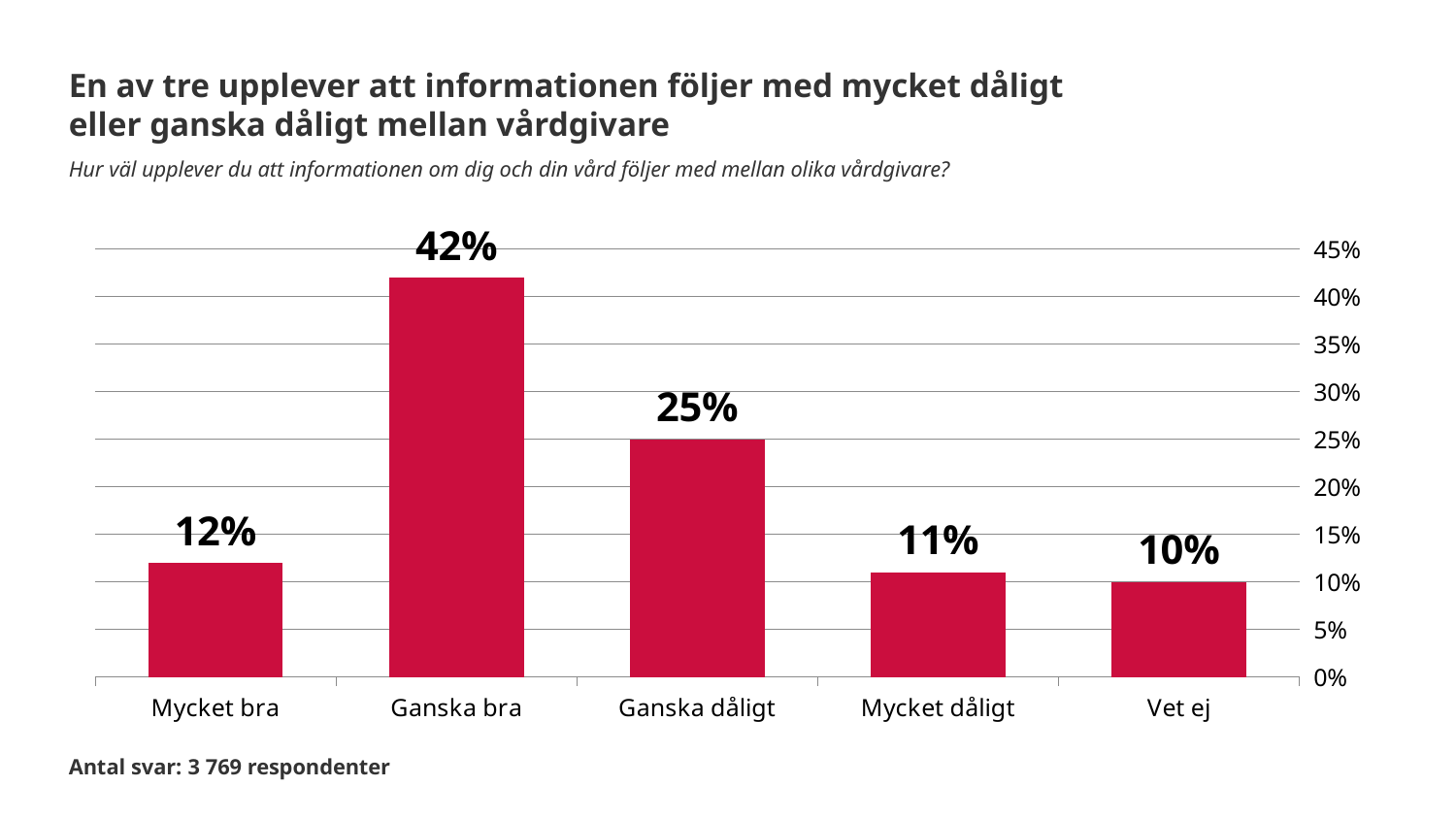
What is the combined value of Ganska dåligt and Mycket dåligt? 36% What kind of chart is shown on the slide? bar chart Which is larger, the value for Mycket bra or the value for Mycket dåligt? Mycket bra How many respondents does the note below the chart say answered? 3 769 What is the value for Mycket bra? 12% Which category has the lowest value? Vet ej Is the value for Ganska dåligt greater or less than 20%? greater Which category has the highest value? Ganska bra What is the value for Ganska bra? 42% What is the difference between the values for Ganska bra and Ganska dåligt? 17% What is the value for Vet ej? 10% How many categories are shown on the x axis? 5